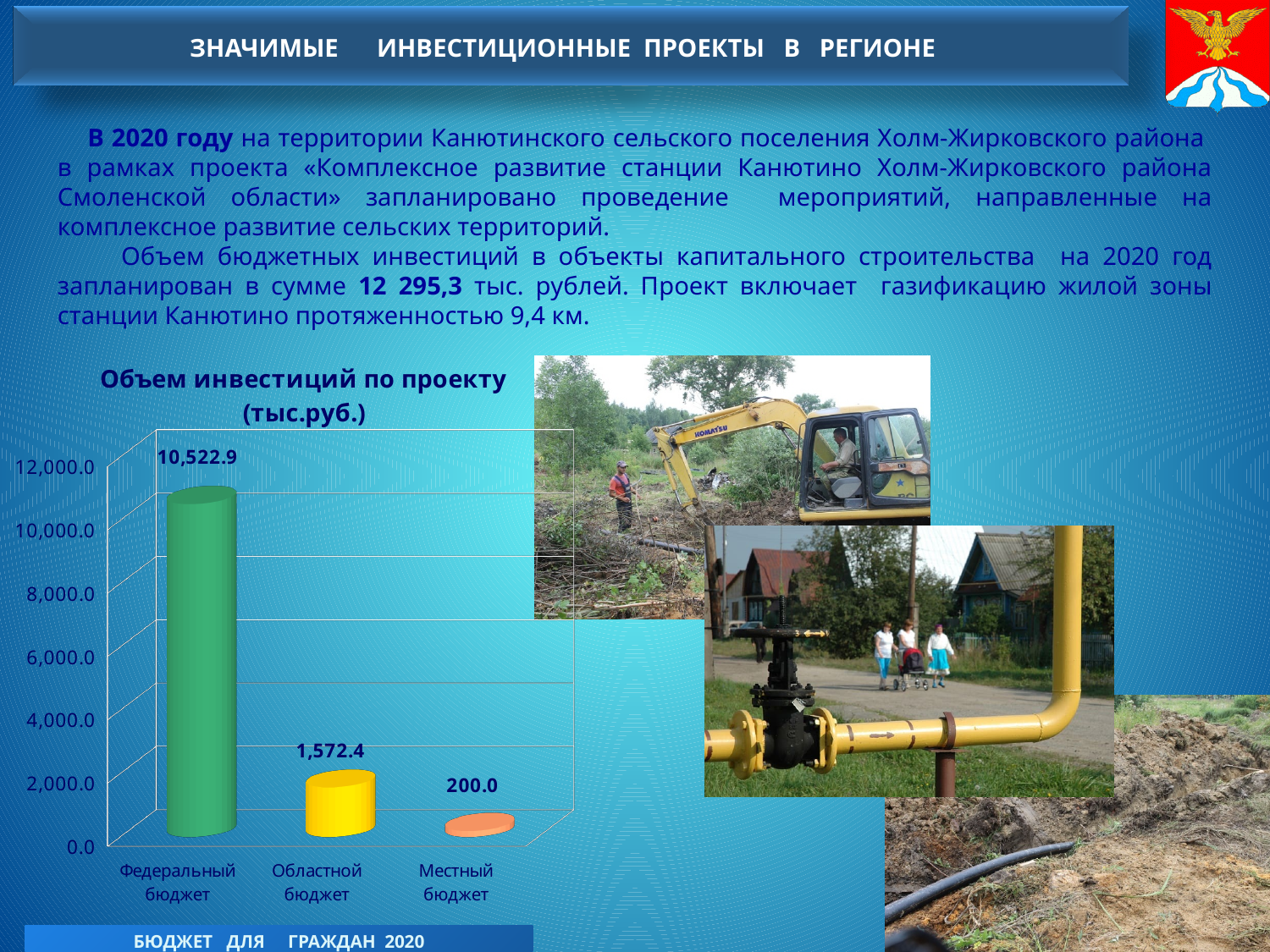
How many categories are shown in the chart? 3 What is the title of the chart? Объем инвестиций по проекту (тыс.руб.) What is the value for Федеральный бюджет in the chart? 10,522.9 What kind of chart is shown on the slide? bar chart What is the value for Областной бюджет in the chart? 1,572.4 Which category has the highest value in the chart? Федеральный бюджет Which category has the lowest value in the chart? Местный бюджет Is the value for Федеральный бюджет greater or less than 10,000.0? greater What is the difference between the values for Федеральный бюджет and Областной бюджет? 8,950.5 What is the value for Местный бюджет in the chart? 200.0 What is the difference between the values for Областной бюджет and Местный бюджет? 1,372.4 Which is larger, the value for Областной бюджет or the value for Местный бюджет? Областной бюджет